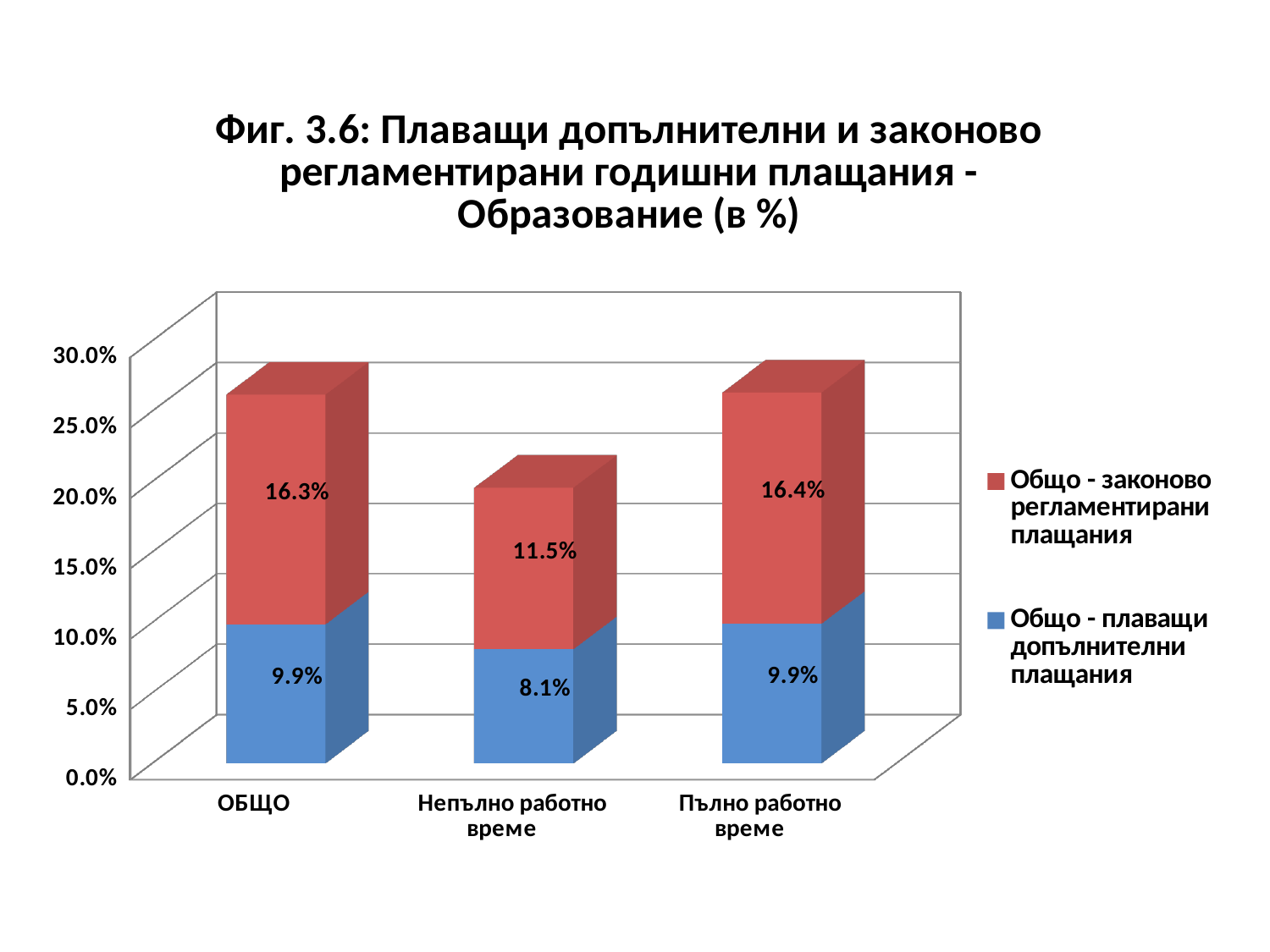
How many categories are shown on the x axis? 3 What is the total of the stacked bar for ОБЩО? 26.2% Which category has the lowest value for Общо - плаващи допълнителни плащания? Непълно работно време Is the total of the stacked bar for Пълно работно време greater or less than 25.0%? greater What is the total of the stacked bar for Непълно работно време? 19.6% What is the value for Общо - законово регламентирани плащания in the ОБЩО category? 16.3% What is the value for Общо - законово регламентирани плащания in the Пълно работно време category? 16.4% What is the value for Общо - плаващи допълнителни плащания in the Пълно работно време category? 9.9% What is the value for Общо - плаващи допълнителни плащания in the Непълно работно време category? 8.1% How many series does the legend list? 2 Which category has the lowest value for Общо - законово регламентирани плащания? Непълно работно време What is the difference between the Общо - законово регламентирани плащания values for ОБЩО and Непълно работно време? 4.8%